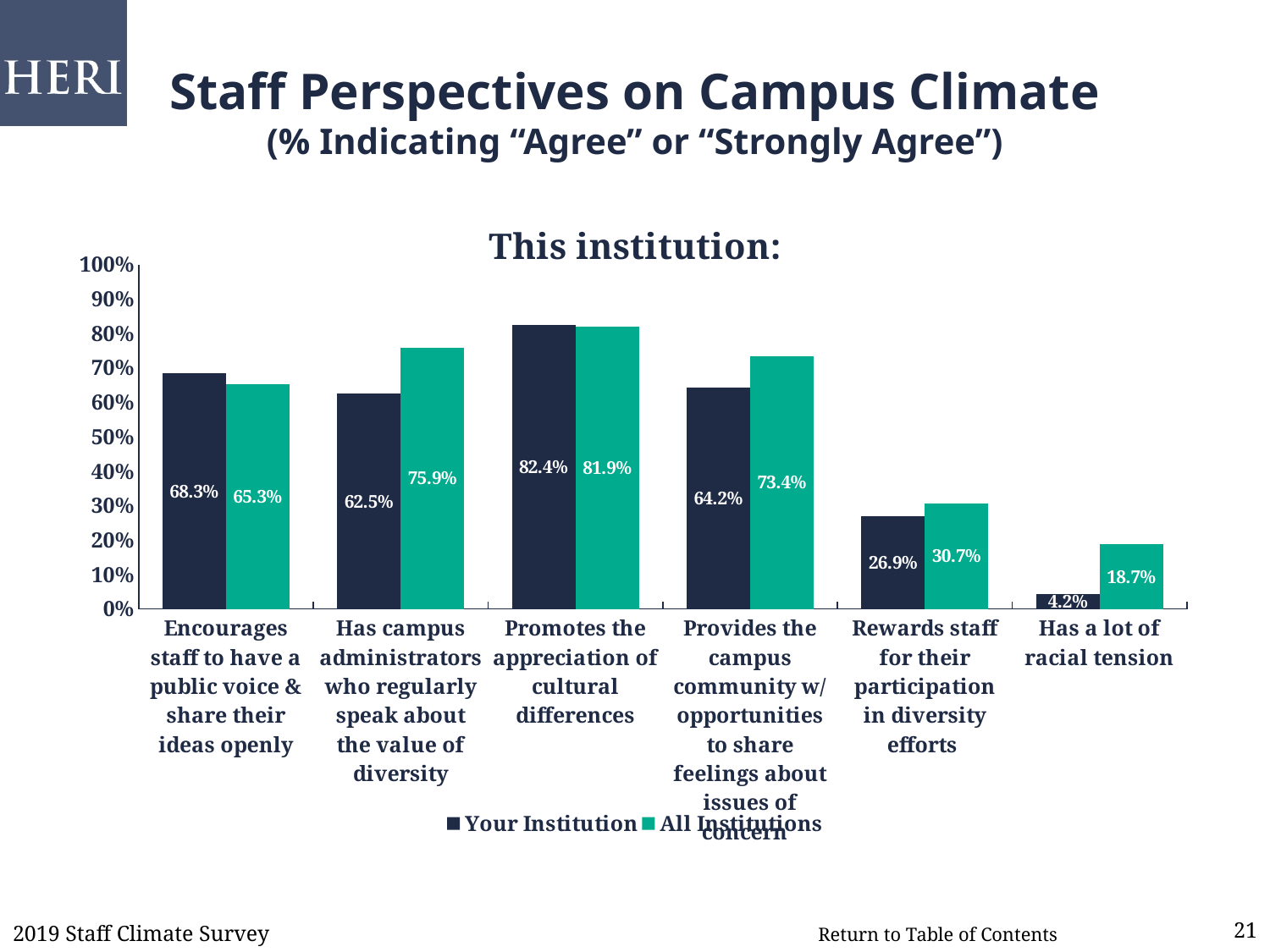
Is the value for Your Institution for "Encourages staff to have a public voice & share their ideas openly" greater or less than 60%? greater What kind of chart is shown on the slide? bar chart Which category has the lowest value for All Institutions? Has a lot of racial tension What is the value for Your Institution for "Promotes the appreciation of cultural differences"? 82.4% What is the title of the chart? This institution: How many categories are shown on the x axis? 6 How many series does the legend list? 2 What is the difference between All Institutions and Your Institution for "Has campus administrators who regularly speak about the value of diversity"? 13.4% Which category has the highest value for Your Institution? Promotes the appreciation of cultural differences What is the value for Your Institution for "Has a lot of racial tension"? 4.2% Which is larger for "Provides the campus community w/ opportunities to share feelings about issues of concern": Your Institution or All Institutions? All Institutions What is the value for All Institutions for "Rewards staff for their participation in diversity efforts"? 30.7%